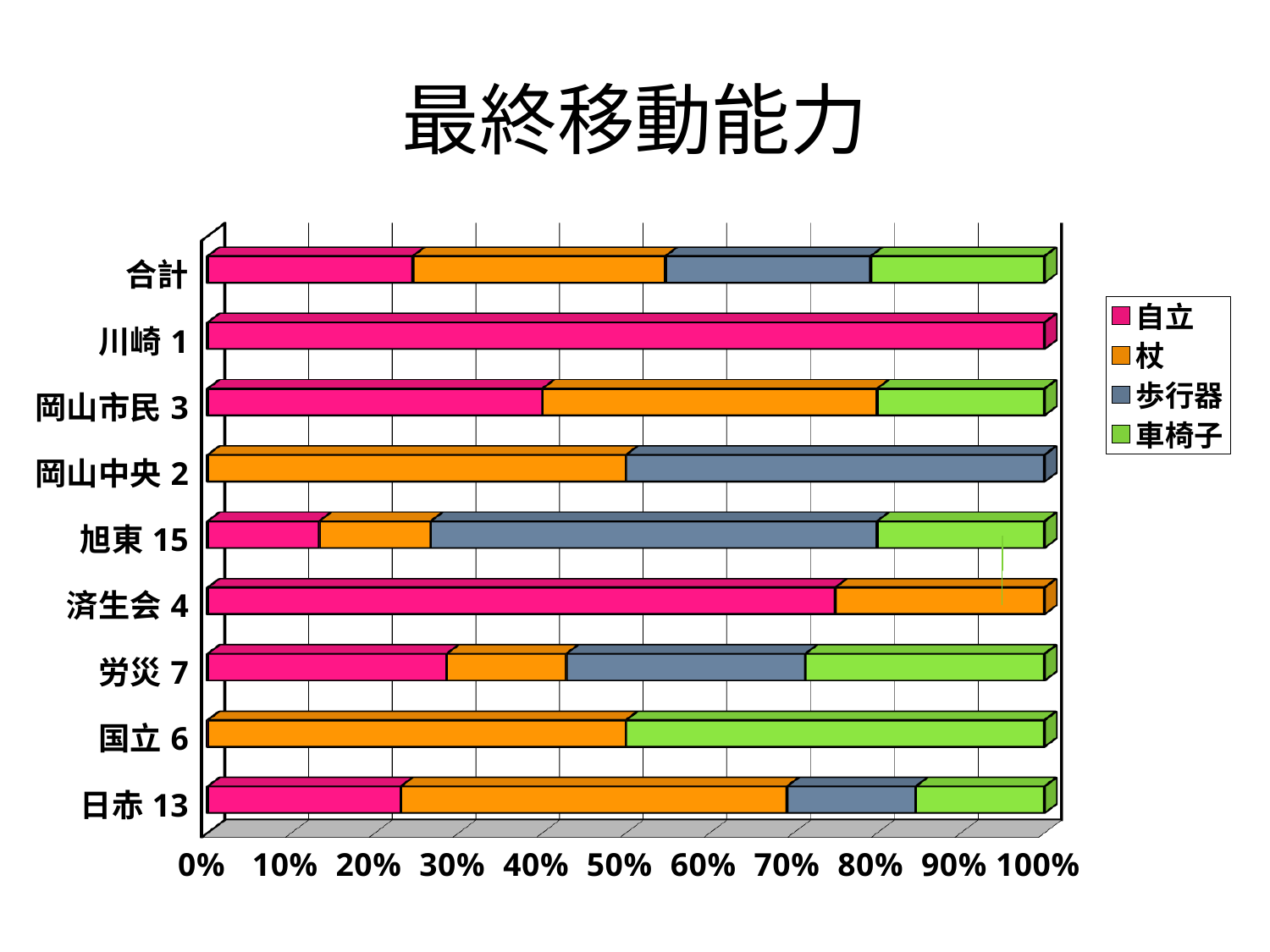
Is the 自立 share for 旭東 15 greater or less than 20%? less What is the 自立 share for 川崎 1? 100% What is the 車椅子 share for 国立 6? 50% Which legend entry is shown in green? 車椅子 What is the title of the chart? 最終移動能力 Is the 自立 share for 岡山市民 3 greater or less than 30%? greater What is the 杖 share for 岡山中央 2? 50% How many series does the legend list? 4 How many categories (rows) are plotted on the chart? 9 What kind of chart is shown on the slide? Stacked bar chart Which has the larger 自立 share, 合計 or 岡山市民 3? 岡山市民 3 Is the 自立 share for 合計 greater or less than 20%? greater